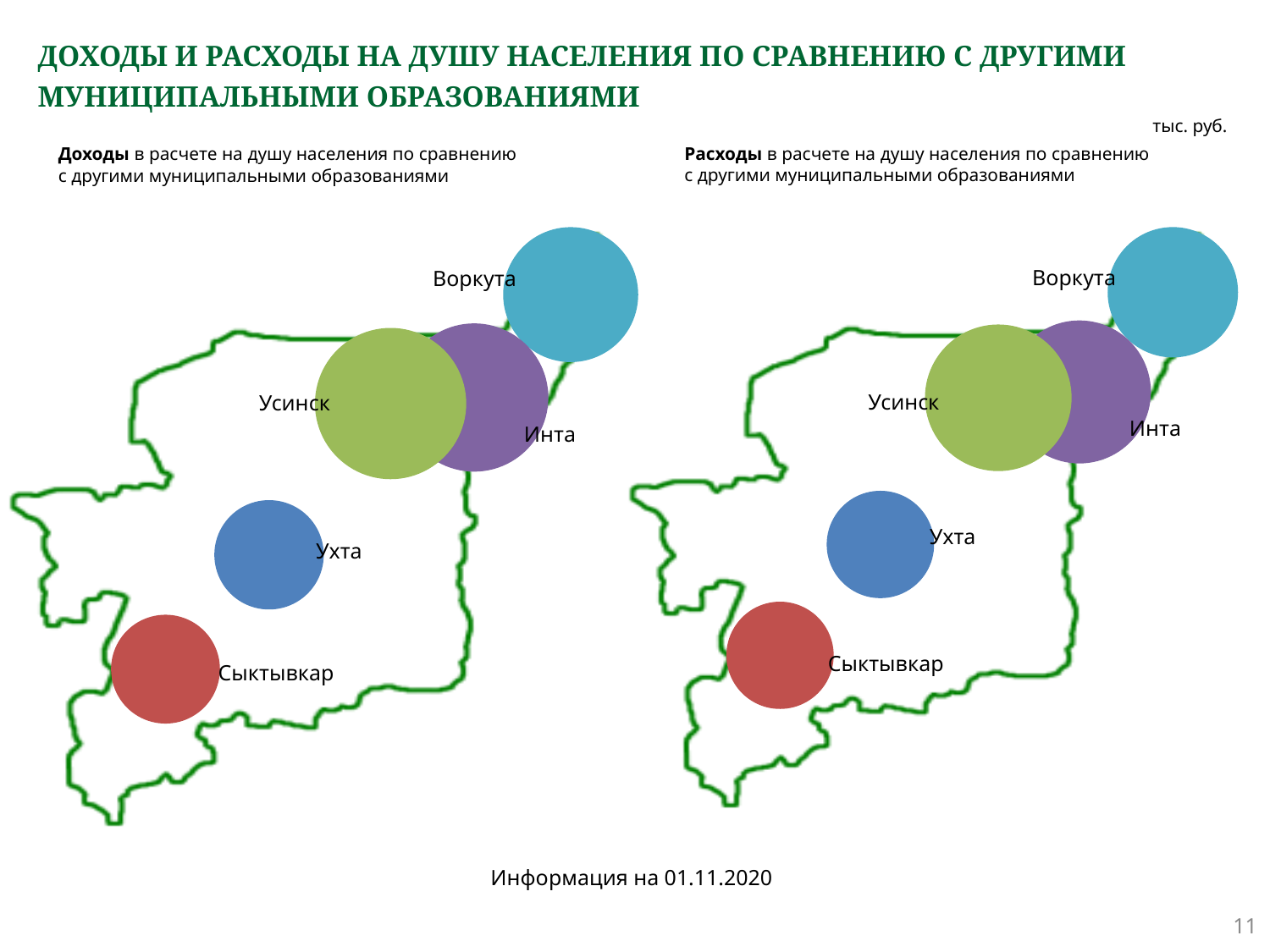
What colour is the bubble for Сыктывкар on the left chart (Доходы)? Red On the left chart (Доходы), which bubble is larger: Усинск or Ухта? Усинск On the right chart (Расходы), which bubble is larger: Усинск or Сыктывкар? Усинск How many municipalities are shown as bubbles on the left chart (Доходы в расчете на душу населения)? 5 What kind of chart is used on the left (Доходы) side of the slide? Bubble chart On the left chart (Доходы), which bubble is larger: Инта or Ухта? Инта What unit of measurement is stated on the slide for the charts? тыс. руб. How many municipalities are shown as bubbles on the right chart (Расходы в расчете на душу населения)? 5 What kind of chart is used on the right (Расходы) side of the slide? Bubble chart Which municipality is represented by the blue bubble in the centre of the right chart (Расходы)? Ухта As of what date is the information on the slide given? 01.11.2020